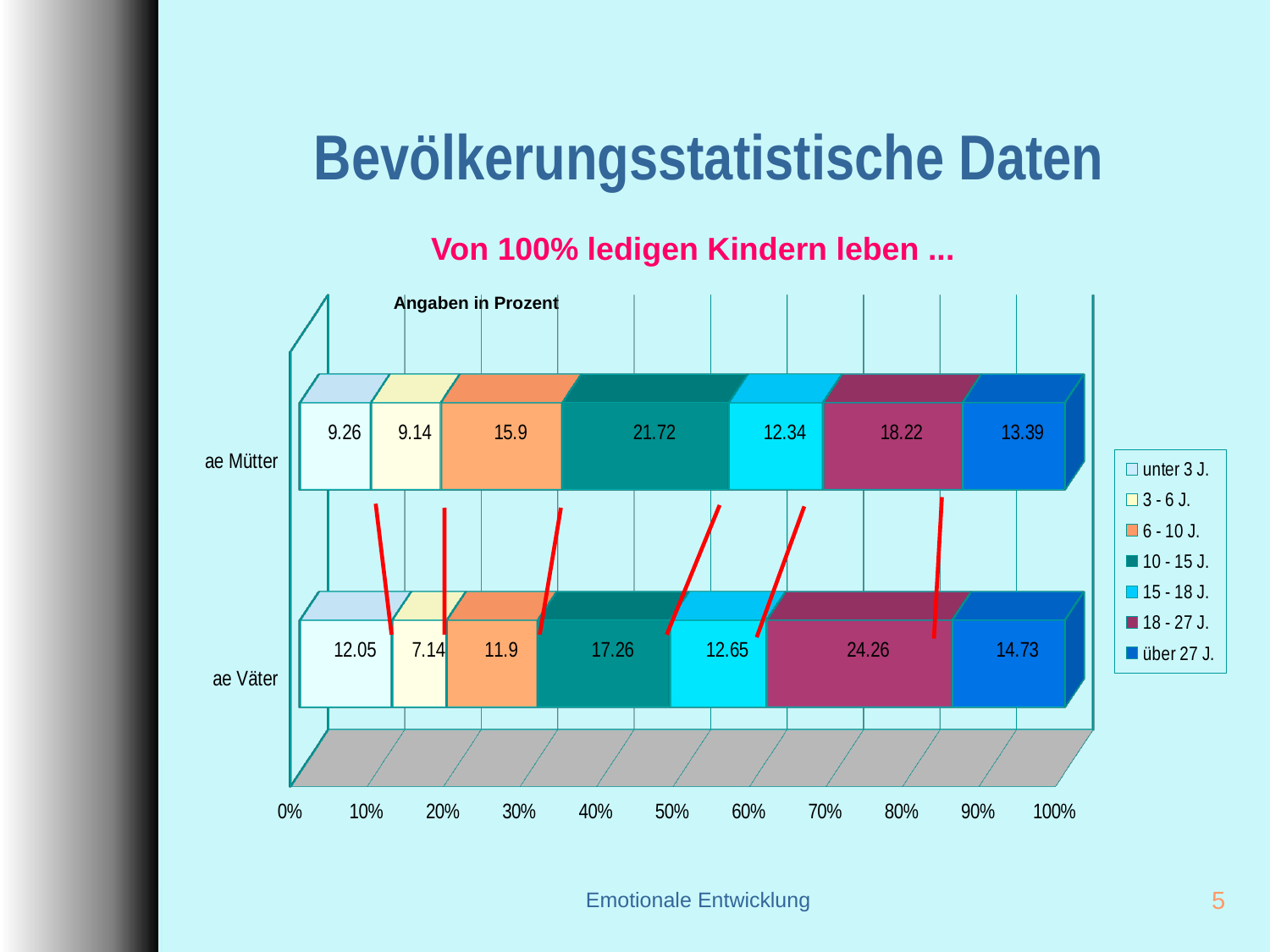
Which age group has the largest segment in the ae Mütter bar? 10 - 15 J. What is the subtitle shown above the chart? Von 100% ledigen Kindern leben ... What is the value of the 18 - 27 J. segment for ae Väter? 24.26 Which age group has the smallest segment in the ae Väter bar? 3 - 6 J. What is the last entry listed in the legend? über 27 J. What is the value of the unter 3 J. segment for ae Väter? 12.05 Which is larger: the 6 - 10 J. value for ae Mütter or for ae Väter? ae Mütter What is the difference between the 18 - 27 J. values for ae Väter and ae Mütter? 6.04 How many series does the legend list? 7 What is the value of the 10 - 15 J. segment for ae Mütter? 21.72 What kind of chart is shown on the slide? stacked bar chart How many categories (bars) are plotted on the chart? 2